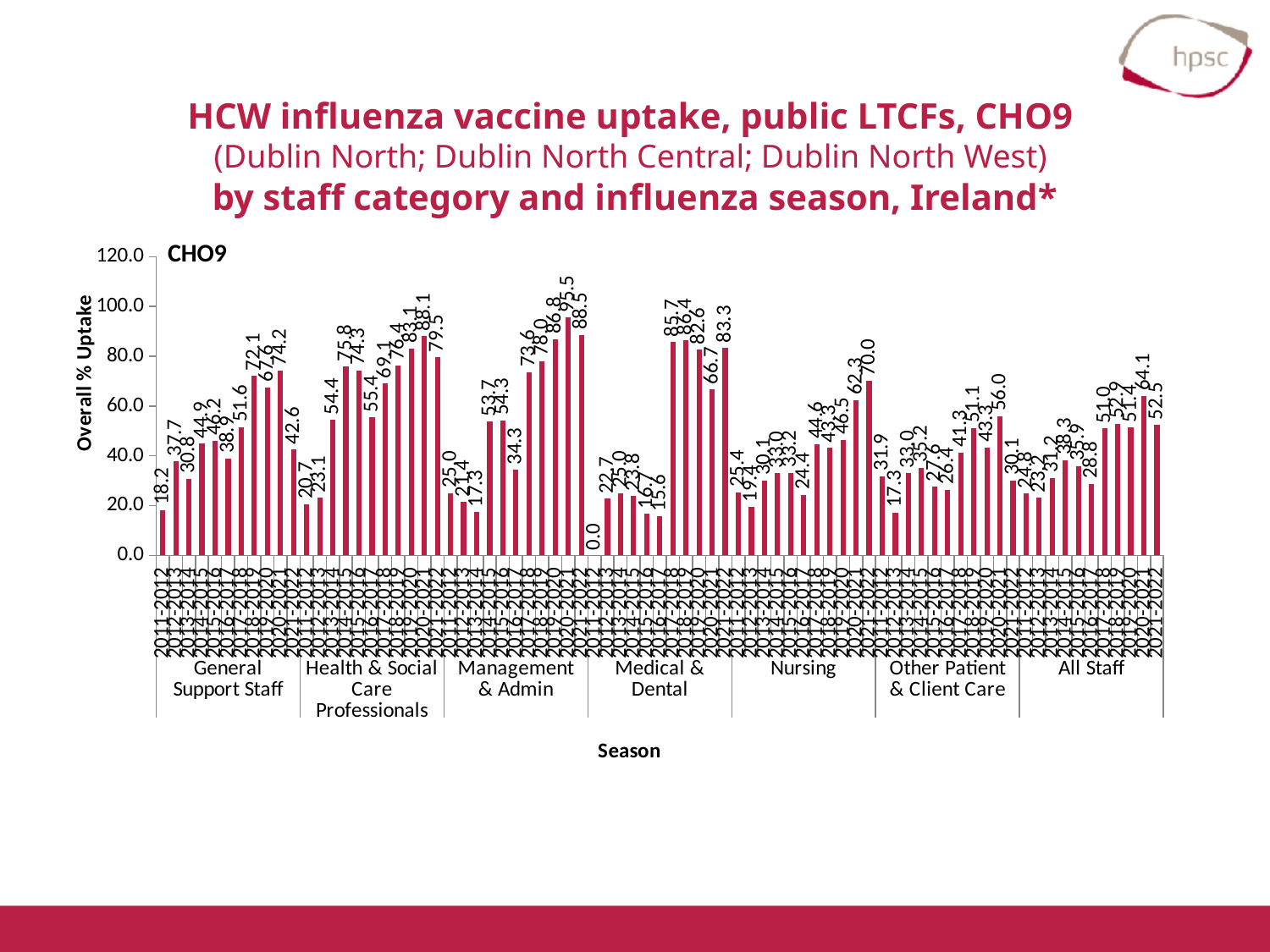
What is the difference in overall % uptake for All Staff between the 2020-2021 season (64.1) and the 2021-2022 season (52.5)? 11.6 What is the overall % uptake for Medical & Dental staff in the 2011-2012 season? 0.0 What kind of chart is shown on the slide? Bar chart What is the overall % uptake for General Support Staff in the 2011-2012 season? 18.2 Which staff category and season has the highest overall % uptake on the chart? Management & Admin, 2020-2021 What is the label of the y axis? Overall % Uptake Which is larger in the 2020-2021 season: the uptake for Management & Admin or for Medical & Dental? Management & Admin What is the overall % uptake for All Staff in the 2021-2022 season? 52.5 How many staff categories are shown along the x axis? 7 What is the overall % uptake for Management & Admin staff in the 2020-2021 season? 95.5 Which staff category and season has the lowest overall % uptake on the chart? Medical & Dental, 2011-2012 Is the overall % uptake for Nursing in the 2021-2022 season greater or less than 60? greater